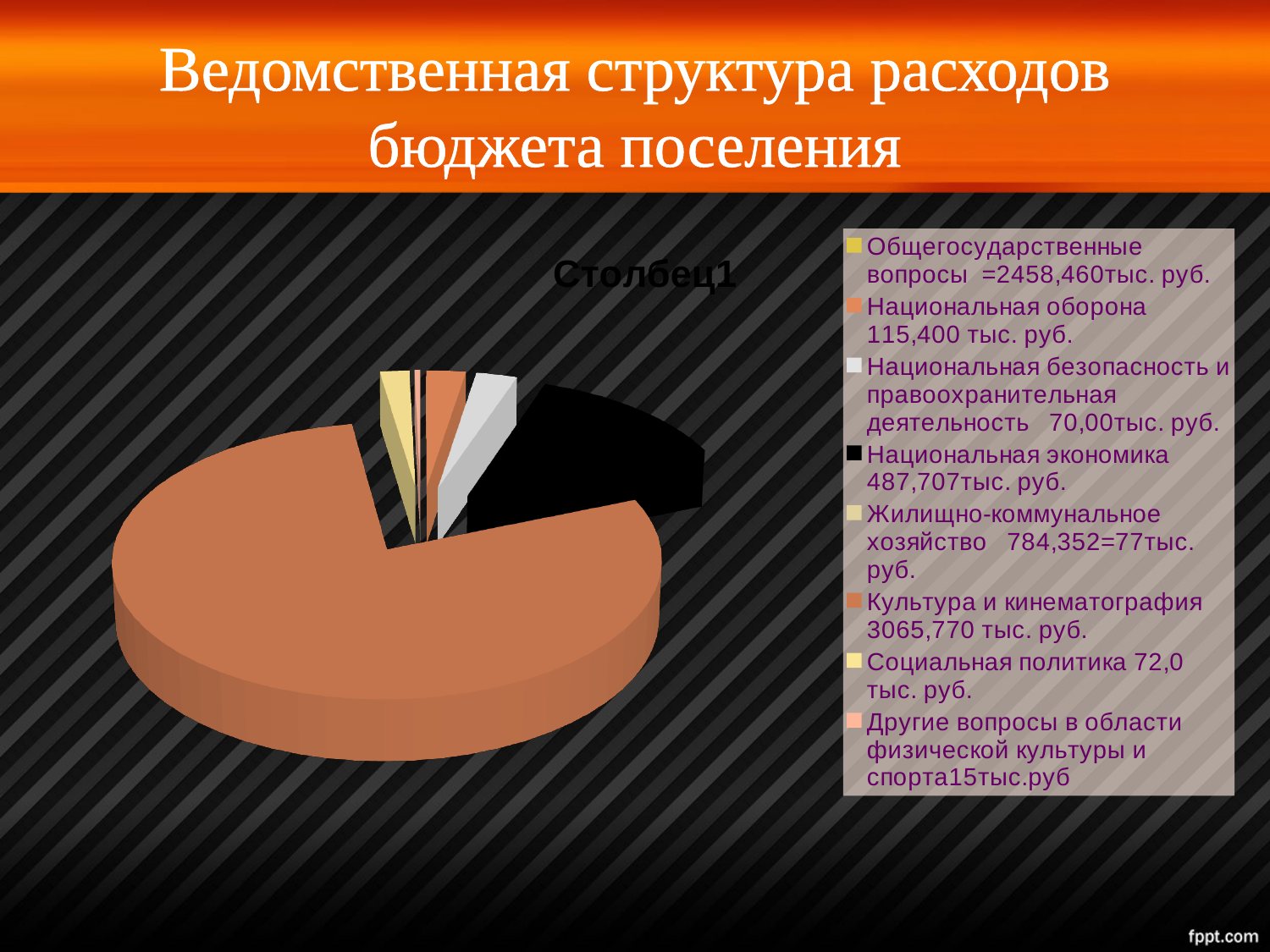
What is the title of the chart? Столбец1 What kind of chart is shown on the slide? Pie chart Which category has the smallest slice of the pie? Другие вопросы в области физической культуры и спорта Which is larger, the value for Национальная экономика or the value for Национальная оборона? Национальная экономика What value does the legend give for Национальная экономика? 487,707тыс. руб. How many categories does the pie chart's legend list? 8 What value does the legend give for Социальная политика? 72,0 тыс. руб. What value does the legend give for Культура и кинематография? 3065,770 тыс. руб. What value does the legend give for Национальная оборона? 115,400 тыс. руб. What is the difference between the values for Национальная экономика and Национальная оборона? 372,307 тыс. руб. Which category has the largest slice of the pie? Культура и кинематография What colour is the slice for Национальная экономика? Black